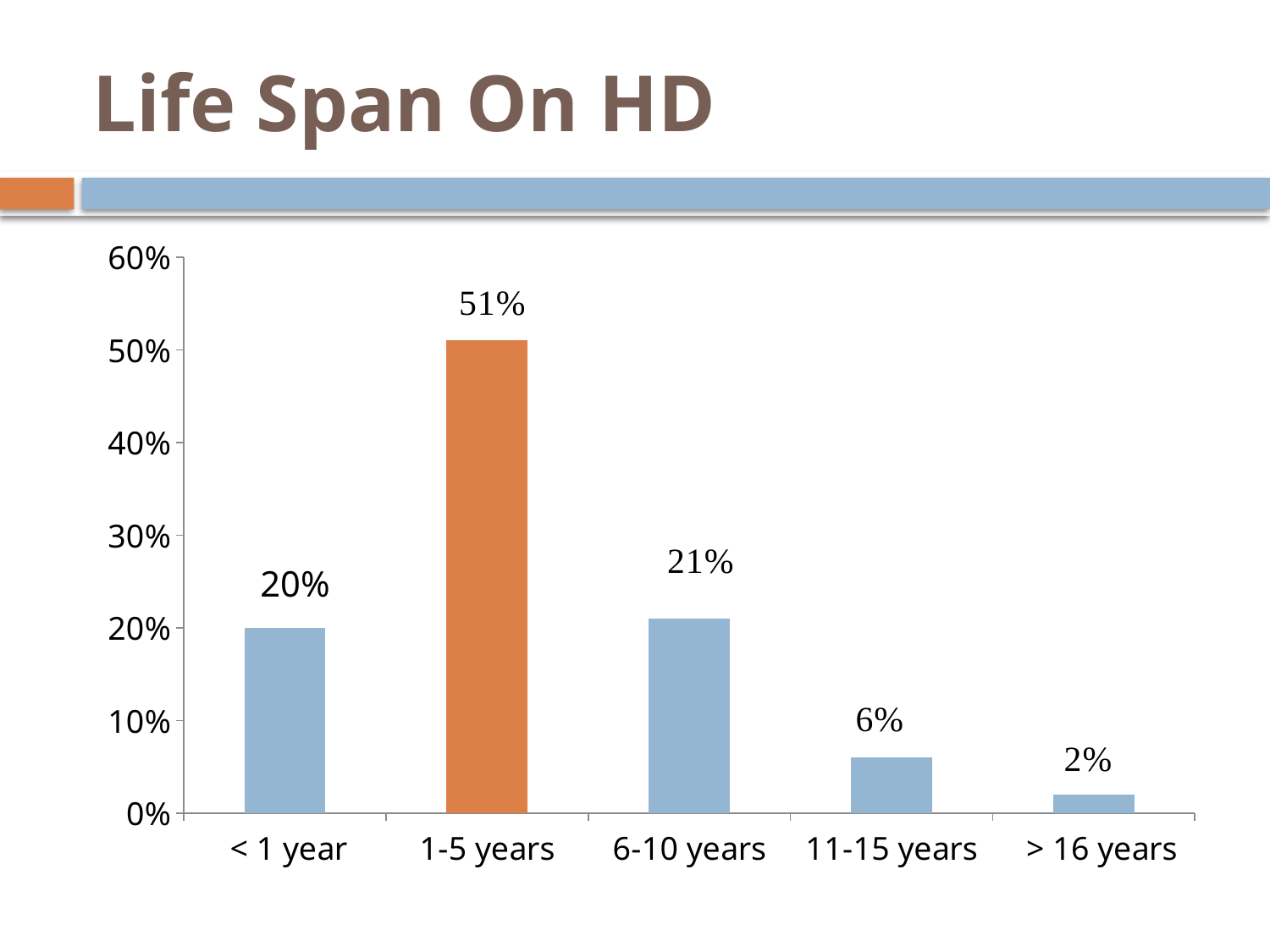
Which is larger, the value for < 1 year or the value for 11-15 years? < 1 year How many categories are shown on the x axis? 5 Which category has the lowest value? > 16 years What is the value for > 16 years? 2% Is the value for 1-5 years greater or less than 40%? greater What is the difference between the values for 1-5 years and 6-10 years? 30% What kind of chart is shown on the slide? bar chart What is the value for 1-5 years? 51% What is the difference between the values for 11-15 years and > 16 years? 4% What is the title of the slide? Life Span On HD What is the value for 6-10 years? 21% Which category has the highest value? 1-5 years